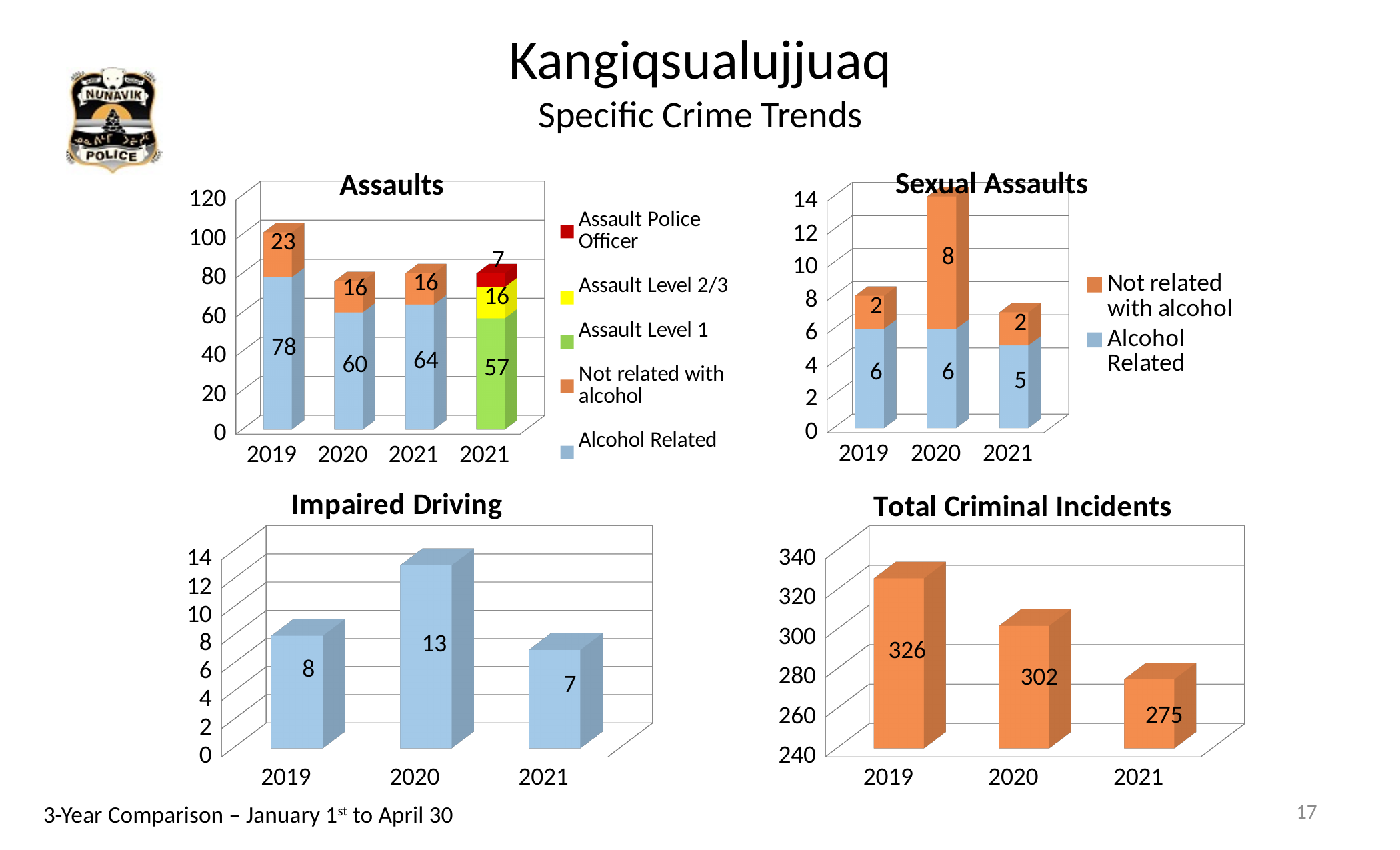
In the Total Criminal Incidents chart, which year has the lowest value? 2021 What kind of chart is the Total Criminal Incidents chart? Bar chart In the Assaults chart, what is the Assault Level 1 value for 2021? 57 In the Sexual Assaults chart, how many series does the legend list? 2 In the Impaired Driving chart, which is larger, the value for 2019 or the value for 2021? 2019 In the Sexual Assaults chart, what is the total of the stacked bar for 2020? 14 In the Assaults chart, what is the total of the stacked bar for 2020? 76 In the Total Criminal Incidents chart, what is the difference between the 2019 and 2021 values? 51 In the Assaults chart, how many series does the legend list? 5 In the Impaired Driving chart, what is the value for 2020? 13 In the Sexual Assaults chart, what is the Not related with alcohol value for 2020? 8 In the Assaults chart, what is the Alcohol Related value for 2019? 78